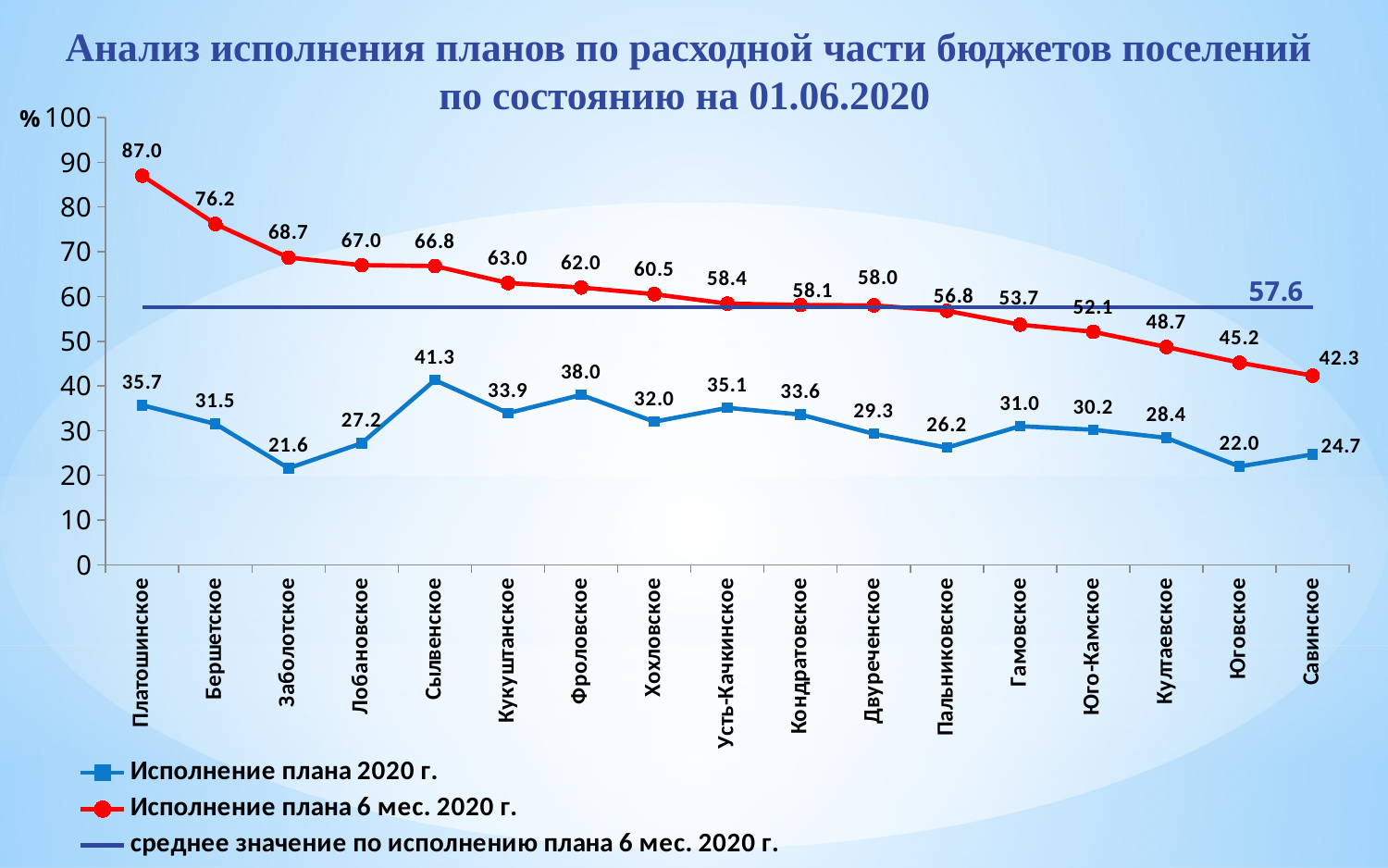
What is the value of "Исполнение плана 2020 г." for Сылвенское? 41.3 Does the "Исполнение плана 6 мес. 2020 г." series generally rise or fall from left to right along the x axis? fall How many settlements (categories) are plotted along the x axis? 17 What type of chart is shown on the slide? line chart What colour is the line for "Исполнение плана 6 мес. 2020 г."? red What is the average value (среднее значение) for the 6-month plan execution shown by the horizontal line? 57.6 How many series does the legend list? 3 Which settlement has the highest value for "Исполнение плана 6 мес. 2020 г."? Платошинское What is the value of "Исполнение плана 6 мес. 2020 г." for Платошинское? 87.0 Which settlement has the lowest value for "Исполнение плана 2020 г."? Заболотское What is the difference between the "Исполнение плана 6 мес. 2020 г." and "Исполнение плана 2020 г." values for Савинское? 17.6 Which is larger: the "Исполнение плана 2020 г." value for Фроловское or for Хохловское? Фроловское